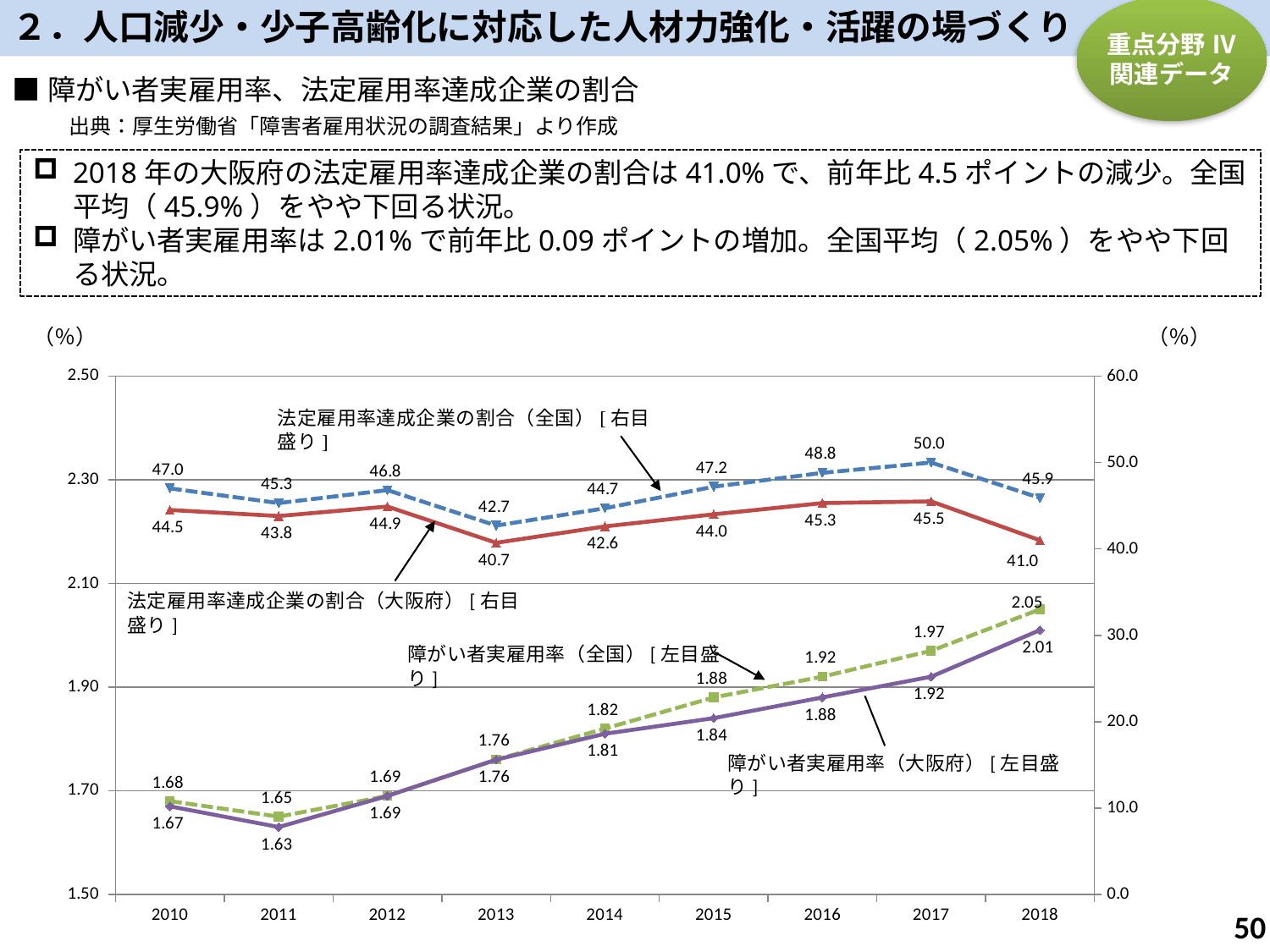
What is the value of 法定雇用率達成企業の割合（大阪府） in 2018? 41.0 What is the value of 障がい者実雇用率（大阪府） in 2011? 1.63 What is the value of 法定雇用率達成企業の割合（全国） in 2017? 50.0 In which year is 法定雇用率達成企業の割合（全国） highest? 2017 What is the value of 障がい者実雇用率（全国） in 2018? 2.05 What is the difference between 法定雇用率達成企業の割合（全国） and 法定雇用率達成企業の割合（大阪府） in 2018? 4.9 In which year is 法定雇用率達成企業の割合（大阪府） lowest? 2013 How many years are plotted along the x axis of the chart? 9 Which is larger in 2015: 障がい者実雇用率（全国） or 障がい者実雇用率（大阪府）? 障がい者実雇用率（全国） What kind of chart is shown on the slide? line chart Which series is drawn as a blue dashed line? 法定雇用率達成企業の割合（全国）[右目盛り] Does 障がい者実雇用率（大阪府） rise or fall from 2011 to 2018? rise